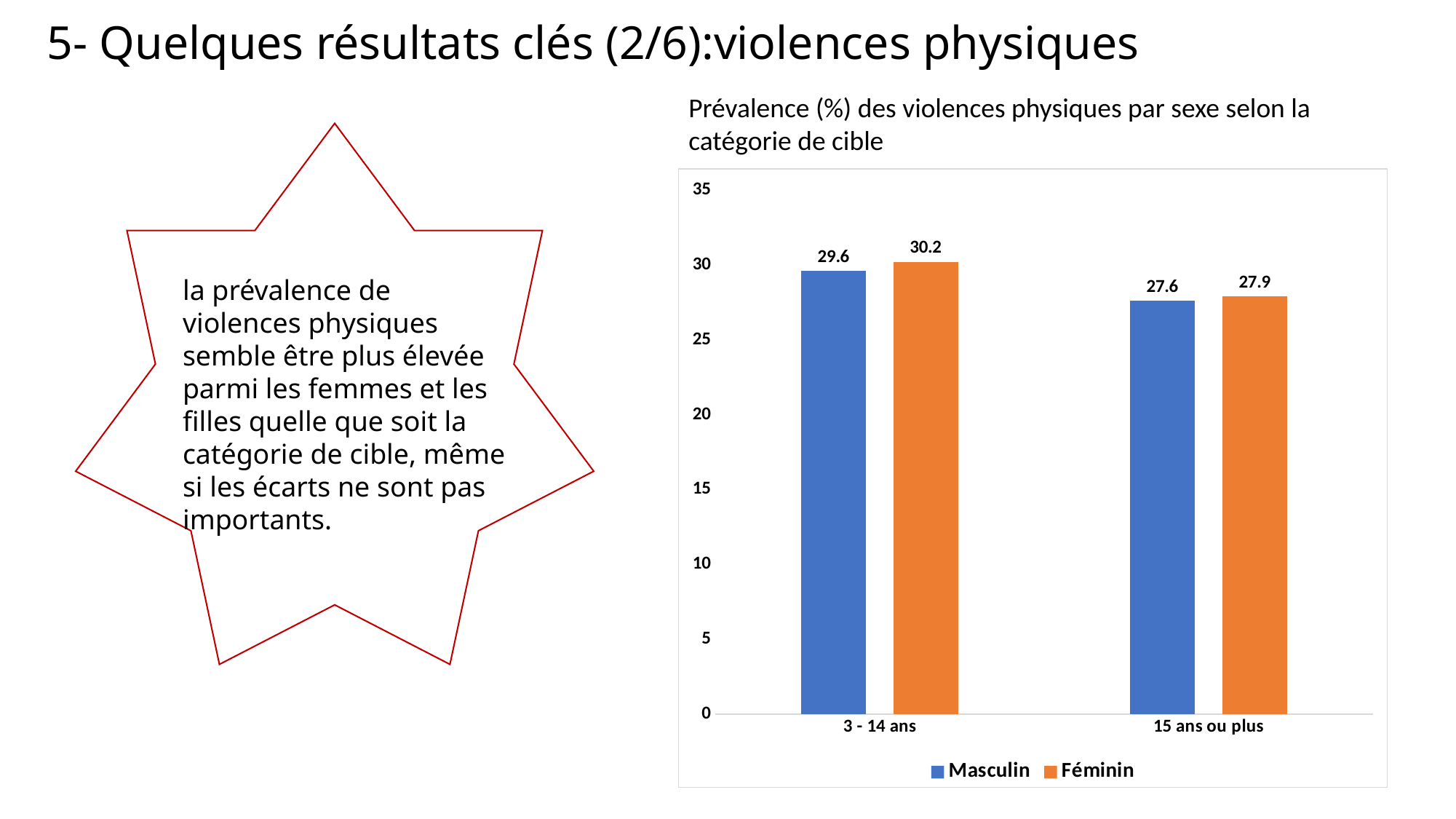
How many categories are shown on the x axis? 2 What is the difference between the Masculin values for 3 - 14 ans and 15 ans ou plus? 2 What is the difference between the Féminin and Masculin values in the 3 - 14 ans category? 0.6 What is the title of the chart? Prévalence (%) des violences physiques par sexe selon la catégorie de cible What is the value for Féminin in the 15 ans ou plus category? 27.9 Which bar has the highest value on the chart? Féminin, 3 - 14 ans What is the value for Féminin in the 3 - 14 ans category? 30.2 What is the value for Masculin in the 15 ans ou plus category? 27.6 What kind of chart is shown on the slide? Bar chart How many series does the legend list? 2 What is the value for Masculin in the 3 - 14 ans category? 29.6 Which bar has the lowest value on the chart? Masculin, 15 ans ou plus